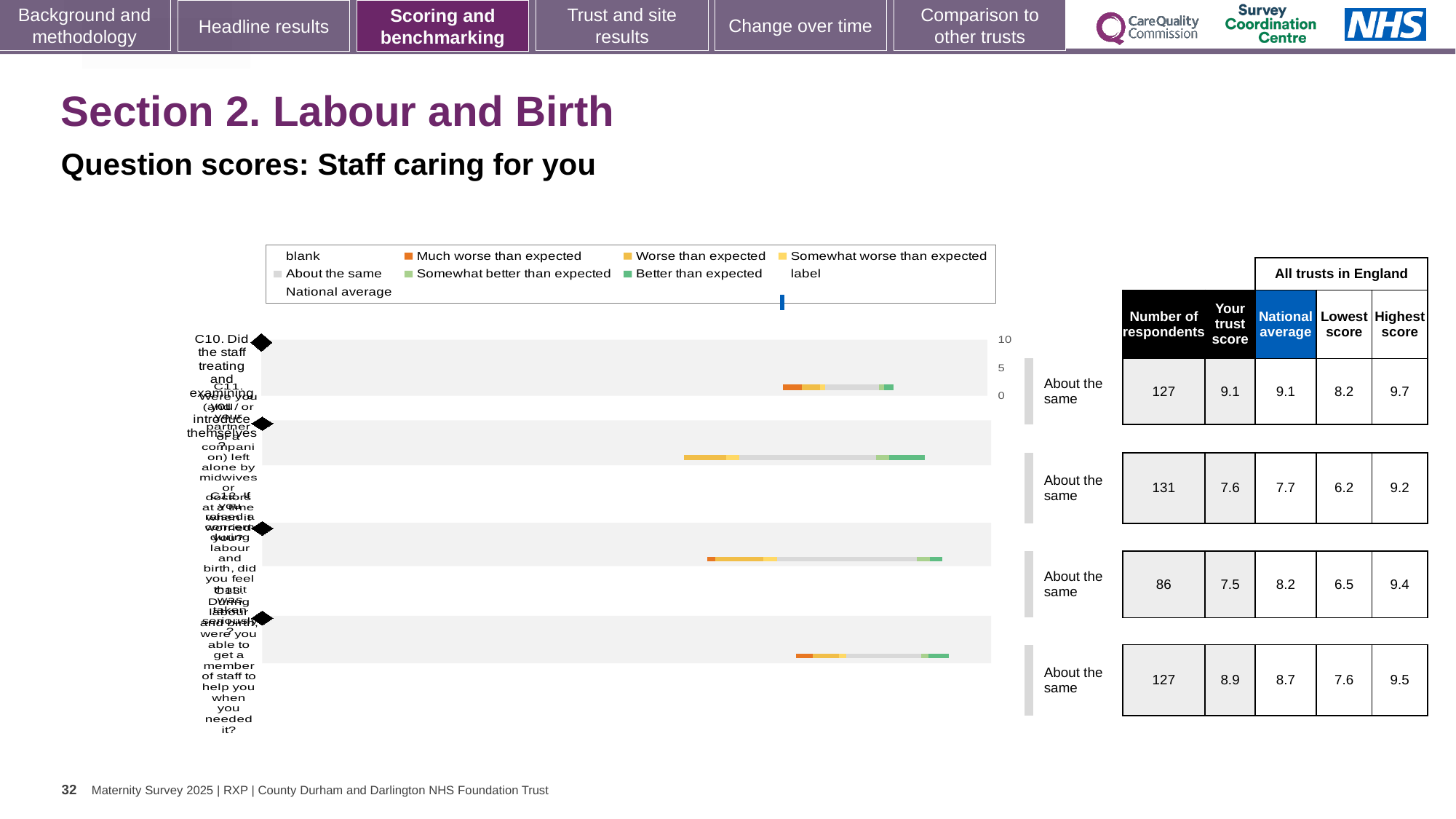
In the table, what is the number of respondents for the first row (C10)? 127 In the table, what is the highest score for the fourth row (C13)? 9.5 Which row in the table has the highest trust score? C10 (9.1) What benchmark category is shown next to each of the four question rows? About the same For the fourth row (C13), is the trust score higher or lower than the national average? Higher How many question rows are shown in the chart and table? 4 In the table, what is the trust score for the second row (C11)? 7.6 What type of chart is shown on the slide? Bar chart Which row in the table has the fewest respondents? C12 (86) What is the difference between the trust score and the national average for the third row (C12)? 0.7 In the table, what is the national average for the third row (C12)? 8.2 In the table, what is the lowest score for the second row (C11)? 6.2